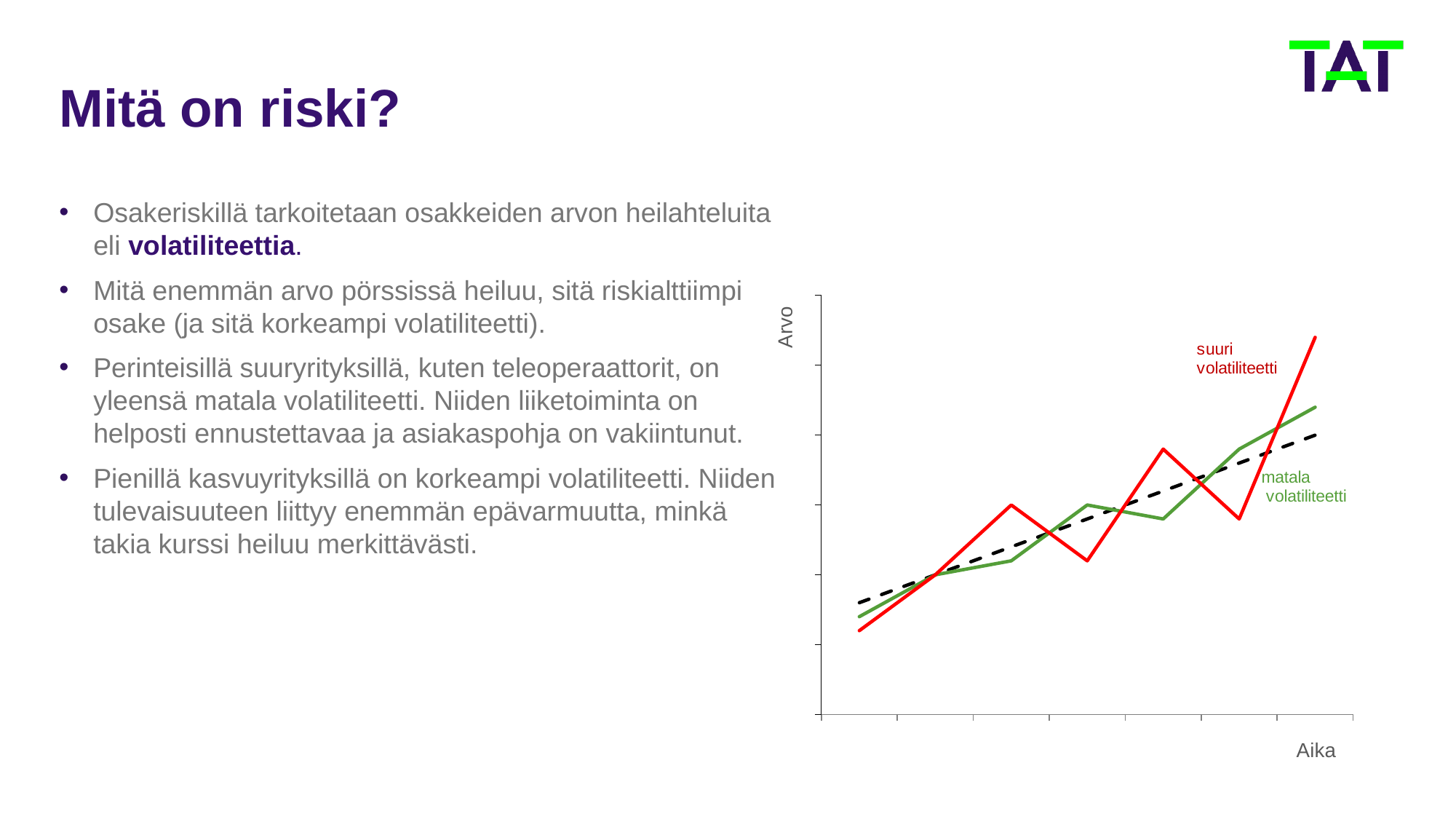
Does the line labelled "matala volatiliteetti" generally rise or fall along the x axis? rise Does the line labelled "suuri volatiliteetti" generally rise or fall along the x axis? rise What is the label of the vertical axis of the chart? Arvo What kind of chart is shown on the slide? line chart Which line ends at the highest value at the right end of the chart, "suuri volatiliteetti" or "matala volatiliteetti"? suuri volatiliteetti Which line starts at the lowest value at the left end of the chart, "suuri volatiliteetti" or "matala volatiliteetti"? suuri volatiliteetti How many labelled lines are shown in the chart? 2 What is the label of the horizontal axis of the chart? Aika